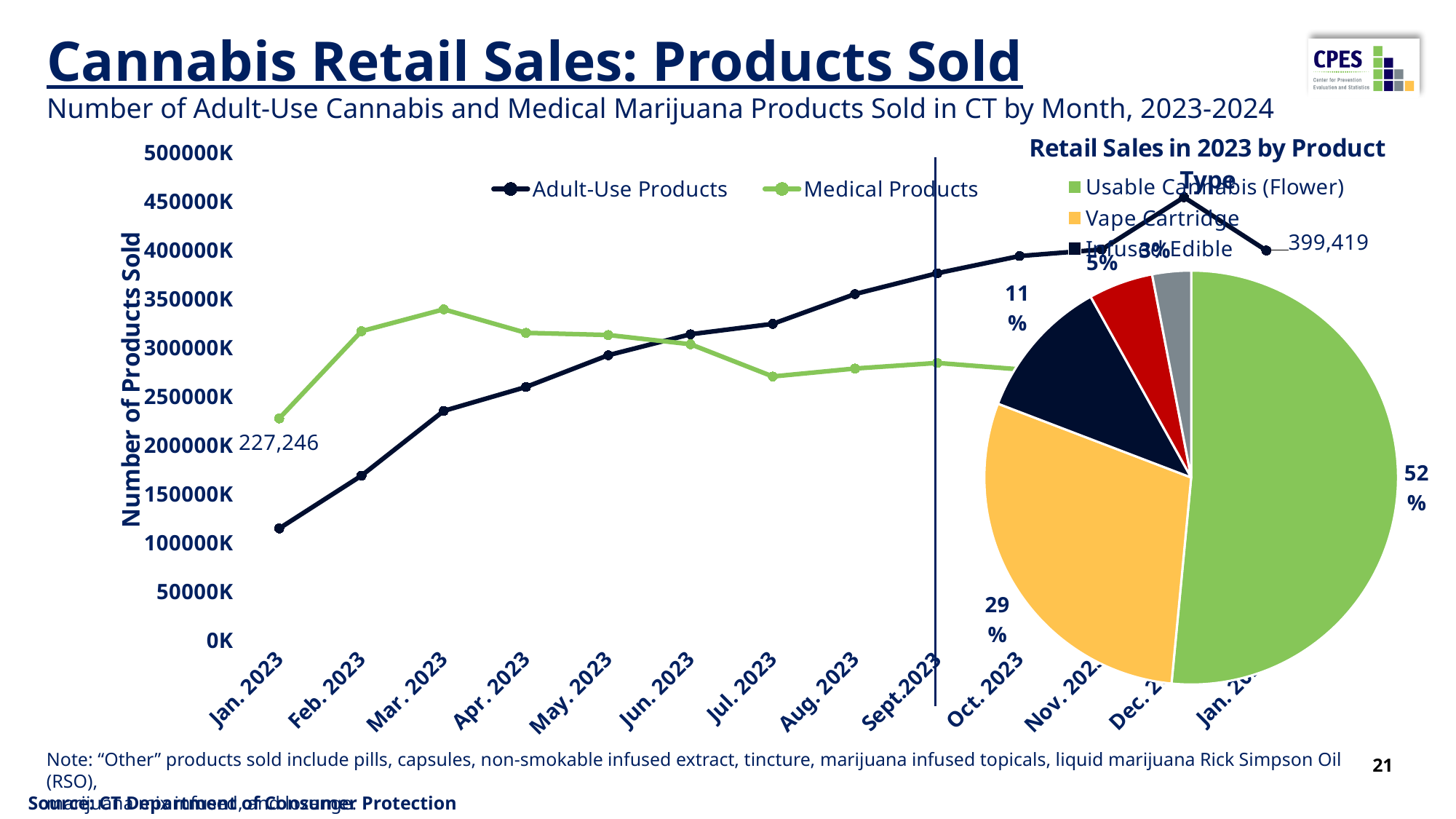
In the line chart, is the value for Medical Products in Mar. 2023 greater or less than 300000K? greater In the pie chart 'Retail Sales in 2023 by Product Type', what share is Vape Cartridge? 29% In the line chart, do Adult-Use Products rise or fall from Jan. 2023 to Dec. 2023? rise How many series does the legend of the line chart list? 2 In the line chart, which series has the higher value in Jan. 2023, Adult-Use Products or Medical Products? Medical Products In the line chart, which series has the higher value in Aug. 2023, Adult-Use Products or Medical Products? Adult-Use Products In the line chart, is the value for Adult-Use Products in Jan. 2023 greater or less than 150000K? less In the pie chart 'Retail Sales in 2023 by Product Type', how many percentage points larger is the Usable Cannabis (Flower) share than the Vape Cartridge share? 23% In the pie chart 'Retail Sales in 2023 by Product Type', what share is Usable Cannabis (Flower)? 52% In the line chart, what is the labelled value for Medical Products in Jan. 2023? 227,246 In the line chart, what is the labelled value for Adult-Use Products in Jan. 2024? 399,419 In the pie chart 'Retail Sales in 2023 by Product Type', which product type has the largest slice? Usable Cannabis (Flower)